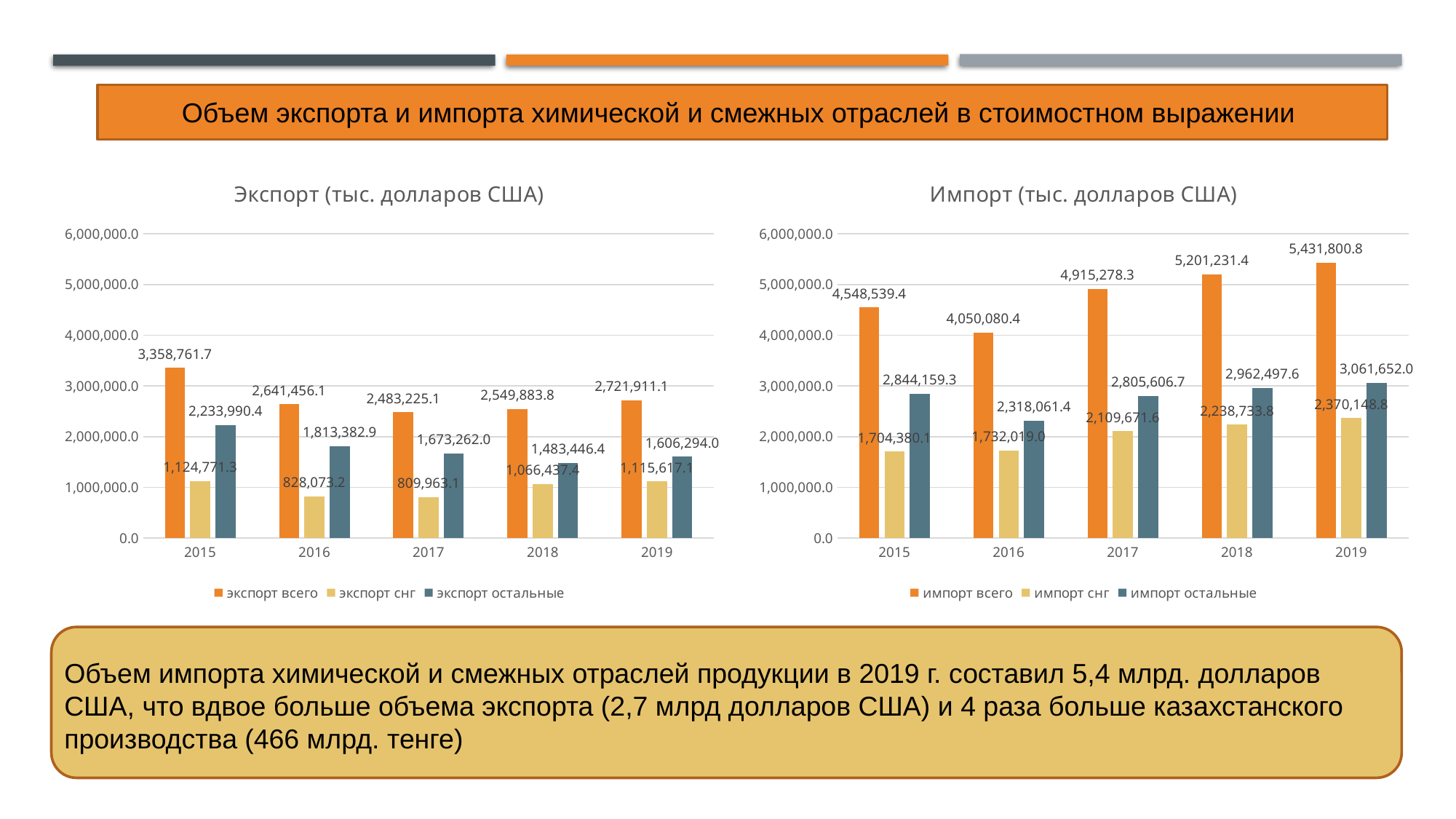
On the Импорт (тыс. долларов США) chart, what is the value of импорт снг for 2017? 2,109,671.6 On the Импорт (тыс. долларов США) chart, which year has the highest value of импорт всего? 2019 What type of chart is the Импорт (тыс. долларов США) chart? bar chart On the Экспорт (тыс. долларов США) chart, which year has the lowest value of экспорт снг? 2017 On the Импорт (тыс. долларов США) chart, which is larger: импорт остальные in 2015 or in 2016? 2015 How many series does the legend of the Экспорт (тыс. долларов США) chart list? 3 On the Экспорт (тыс. долларов США) chart, is the value of экспорт остальные for 2018 greater or less than 2,000,000.0? less On the Экспорт (тыс. долларов США) chart, what is the value of экспорт всего for 2015? 3,358,761.7 On the Экспорт (тыс. долларов США) chart, what is the difference between экспорт всего in 2015 and in 2019? 636,850.6 On the Импорт (тыс. долларов США) chart, what is the value of импорт остальные for 2019? 3,061,652.0 On the Импорт (тыс. долларов США) chart, does импорт снг rise or fall from 2015 to 2019? rise How many years are shown on the x axis of the Импорт (тыс. долларов США) chart? 5